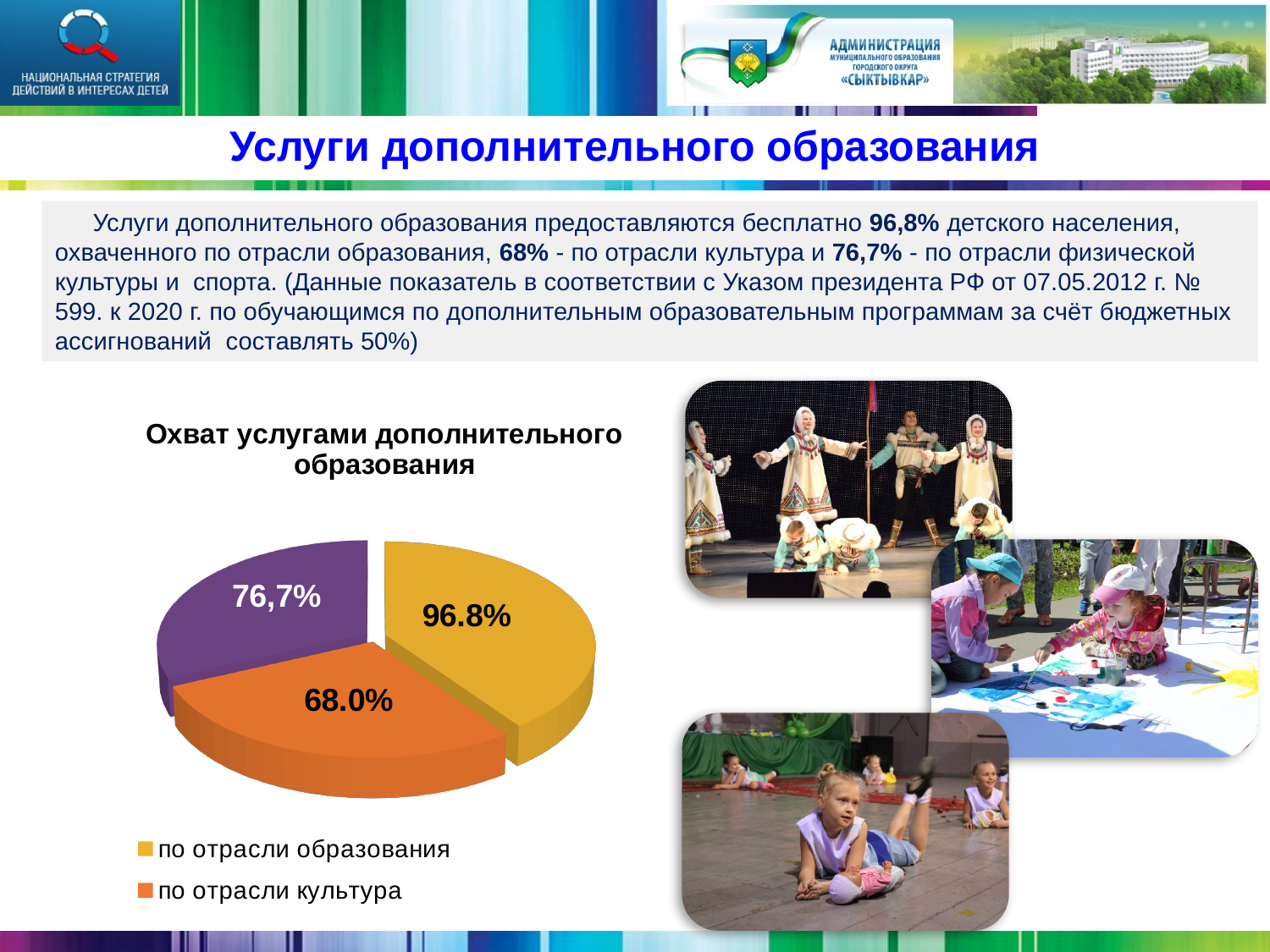
What value is shown for "по отрасли образования" in the pie chart? 96.8% What kind of chart is shown on the slide? pie chart Which is larger: the value for "по отрасли образования" or for "по отрасли культура"? по отрасли образования How many entries does the chart legend list? 2 What colour is the slice for "по отрасли образования"? yellow Which slice of the pie chart has the smallest value? по отрасли культура What is the chart's title? Охват услугами дополнительного образования Which slice of the pie chart has the largest value? по отрасли образования How many slices does the pie chart have? 3 What is the difference between the values for "по отрасли образования" and "по отрасли культура"? 28.8 percentage points What value is printed on the purple slice of the pie chart? 76,7% What value is shown for "по отрасли культура" in the pie chart? 68.0%